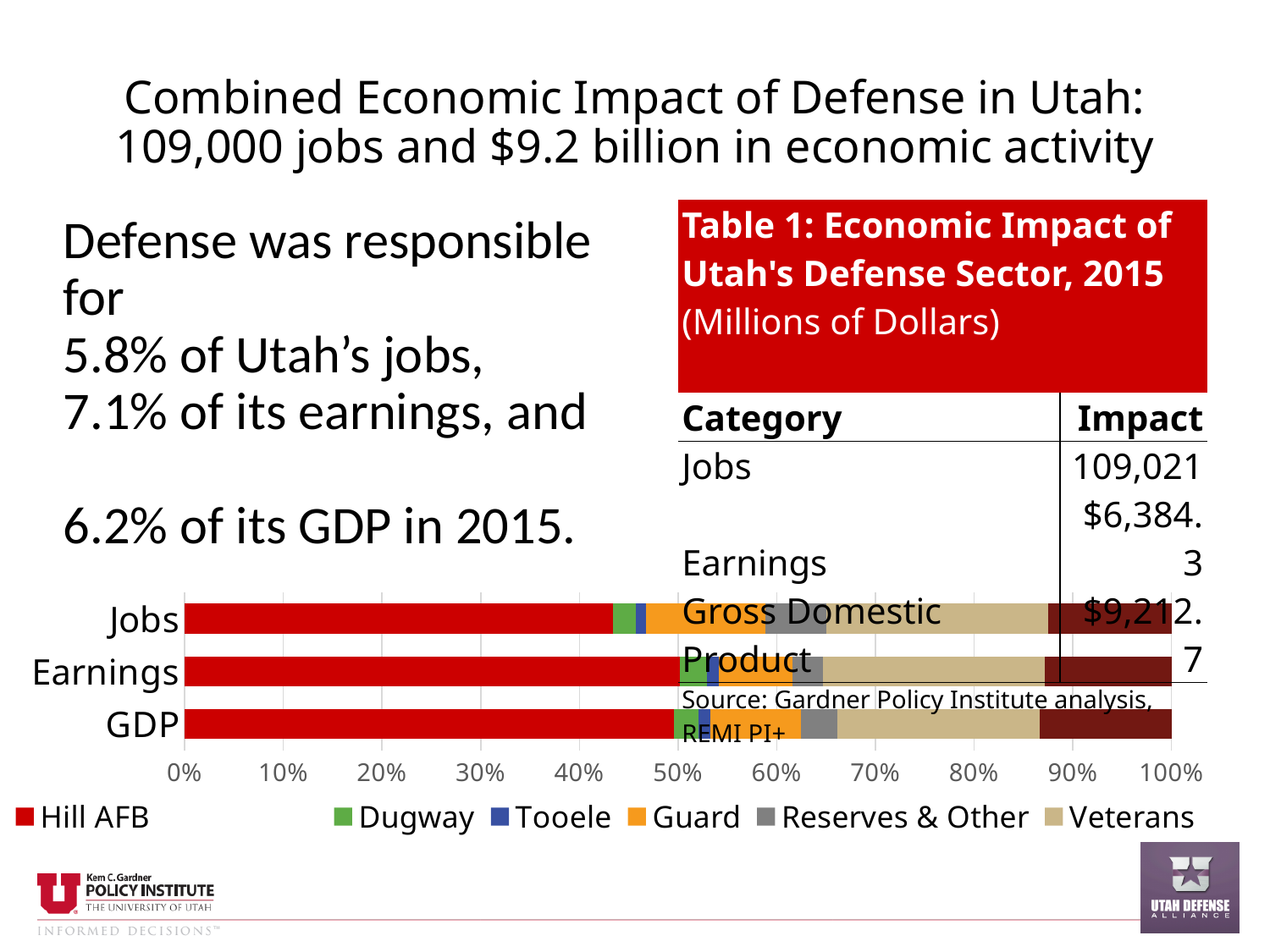
Is the Hill AFB share of the Earnings bar greater or less than 40%? greater Which category has the smallest Hill AFB share: Jobs, Earnings or GDP? Jobs Is the Hill AFB share of the Jobs bar greater or less than 40%? greater How many categories are plotted on the y axis of the bar chart? 3 What is the highest value shown on the x axis of the bar chart? 100% Is the Hill AFB share of the Jobs bar greater or less than 50%? less How many series does the chart legend list? 6 Is the Hill AFB share larger for Jobs or for Earnings? Earnings Which categories are shown on the y axis of the bar chart? Jobs, Earnings, GDP What colour represents Hill AFB in the chart legend? red What kind of chart is shown at the bottom of the slide? stacked bar chart